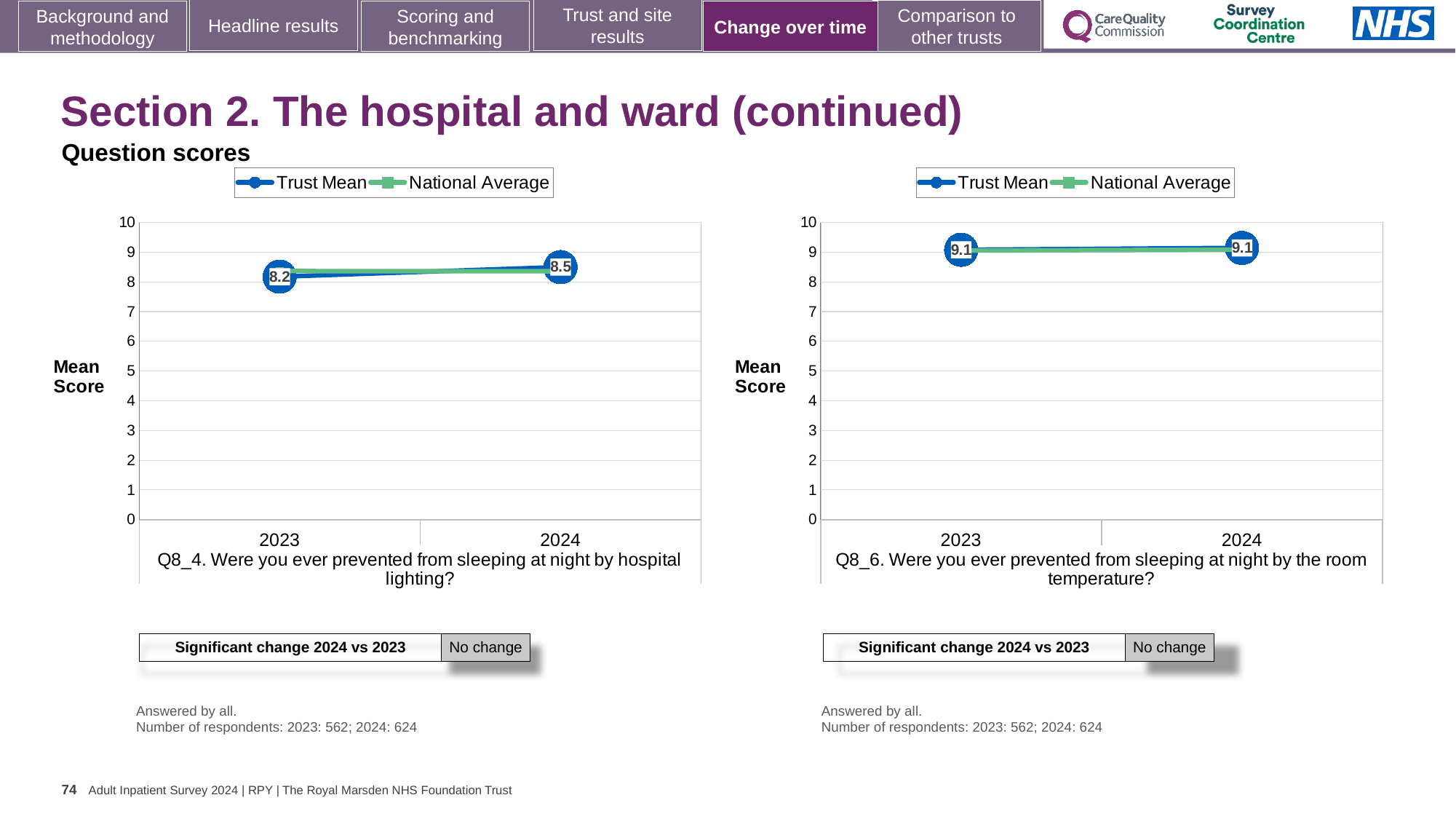
How many years are shown on the x axis of the left chart (Q8_4, hospital lighting)? 2 In the left chart (Q8_4, hospital lighting), what is the Trust Mean for 2024? 8.5 In the left chart (Q8_4, hospital lighting), which year has the higher Trust Mean? 2024 In the left chart (Q8_4, hospital lighting), what is the Trust Mean for 2023? 8.2 In the left chart (Q8_4, hospital lighting), by how much did the Trust Mean change from 2023 to 2024? 0.3 In the right chart (Q8_6, room temperature), does the Trust Mean rise, fall or stay the same from 2023 to 2024? stay the same What does the 'Significant change 2024 vs 2023' box under the left chart (Q8_4, hospital lighting) say? No change In the right chart (Q8_6, room temperature), what is the Trust Mean for 2024? 9.1 In the left chart (Q8_4, hospital lighting), does the Trust Mean rise or fall from 2023 to 2024? rise In the right chart (Q8_6, room temperature), is the National Average for 2023 greater or less than 8? greater How many series does the legend of the right chart (Q8_6, room temperature) list? 2 What kind of chart is the left chart (Q8_4, hospital lighting)? line chart